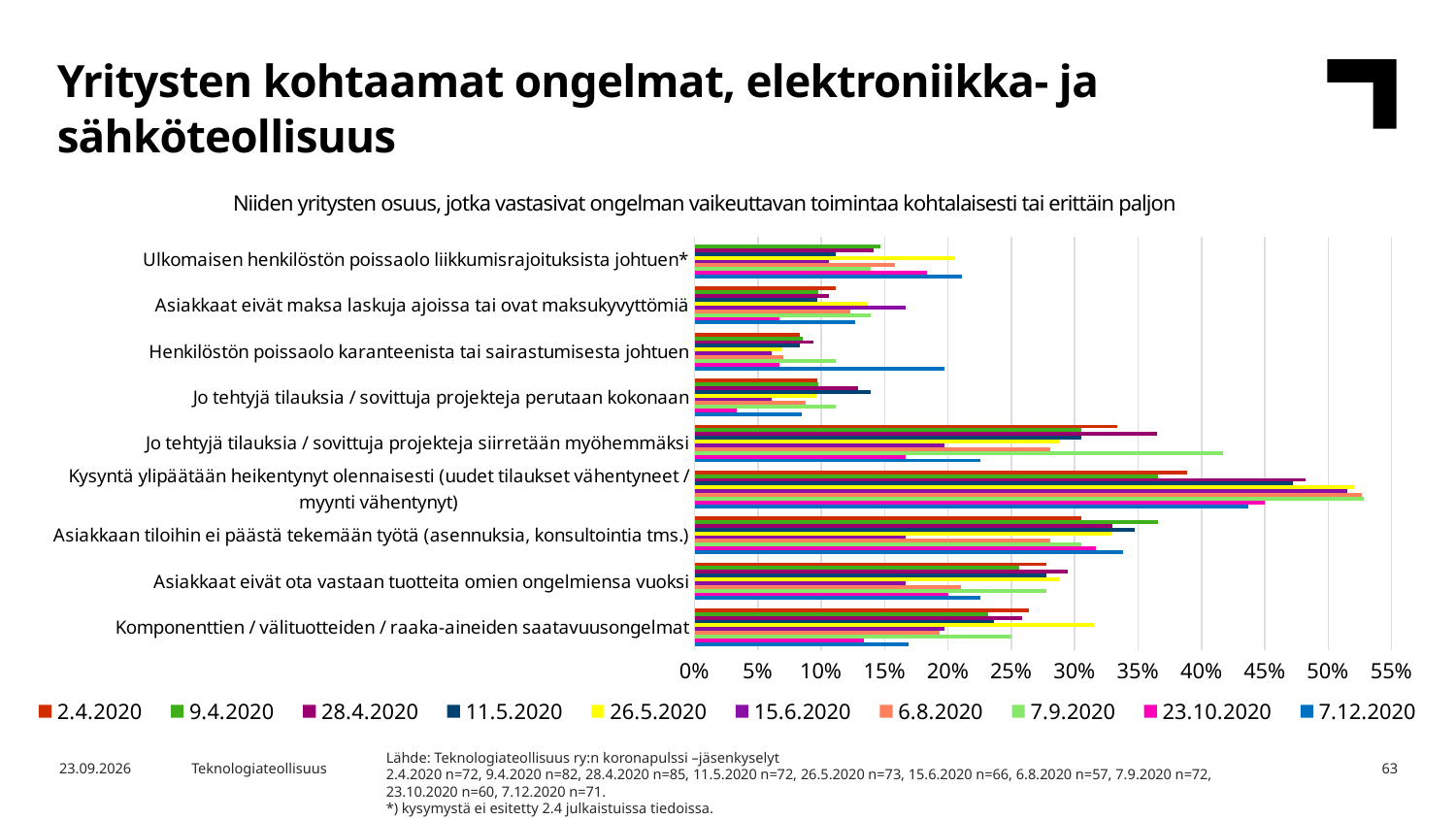
For 'Komponenttien / välituotteiden / raaka-aineiden saatavuusongelmat', which is larger: the 26.5.2020 value or the 7.12.2020 value? 26.5.2020 How many problem categories are listed on the chart? 9 Is the 26.5.2020 value for 'Kysyntä ylipäätään heikentynyt olennaisesti' greater or less than 50%? greater Is the 26.5.2020 value for 'Komponenttien / välituotteiden / raaka-aineiden saatavuusongelmat' greater or less than 30%? greater What kind of chart is shown on the slide? Bar chart Is the 7.12.2020 value for 'Asiakkaan tiloihin ei päästä tekemään työtä' greater or less than 30%? greater For the 2.4.2020 series, which is larger: 'Kysyntä ylipäätään heikentynyt olennaisesti' or 'Jo tehtyjä tilauksia / sovittuja projekteja siirretään myöhemmäksi'? Kysyntä ylipäätään heikentynyt olennaisesti What is the highest value shown on the horizontal axis of the chart? 55% Which category has the highest values overall on the chart? Kysyntä ylipäätään heikentynyt olennaisesti (uudet tilaukset vähentyneet / myynti vähentynyt) How many series (survey dates) does the legend list? 10